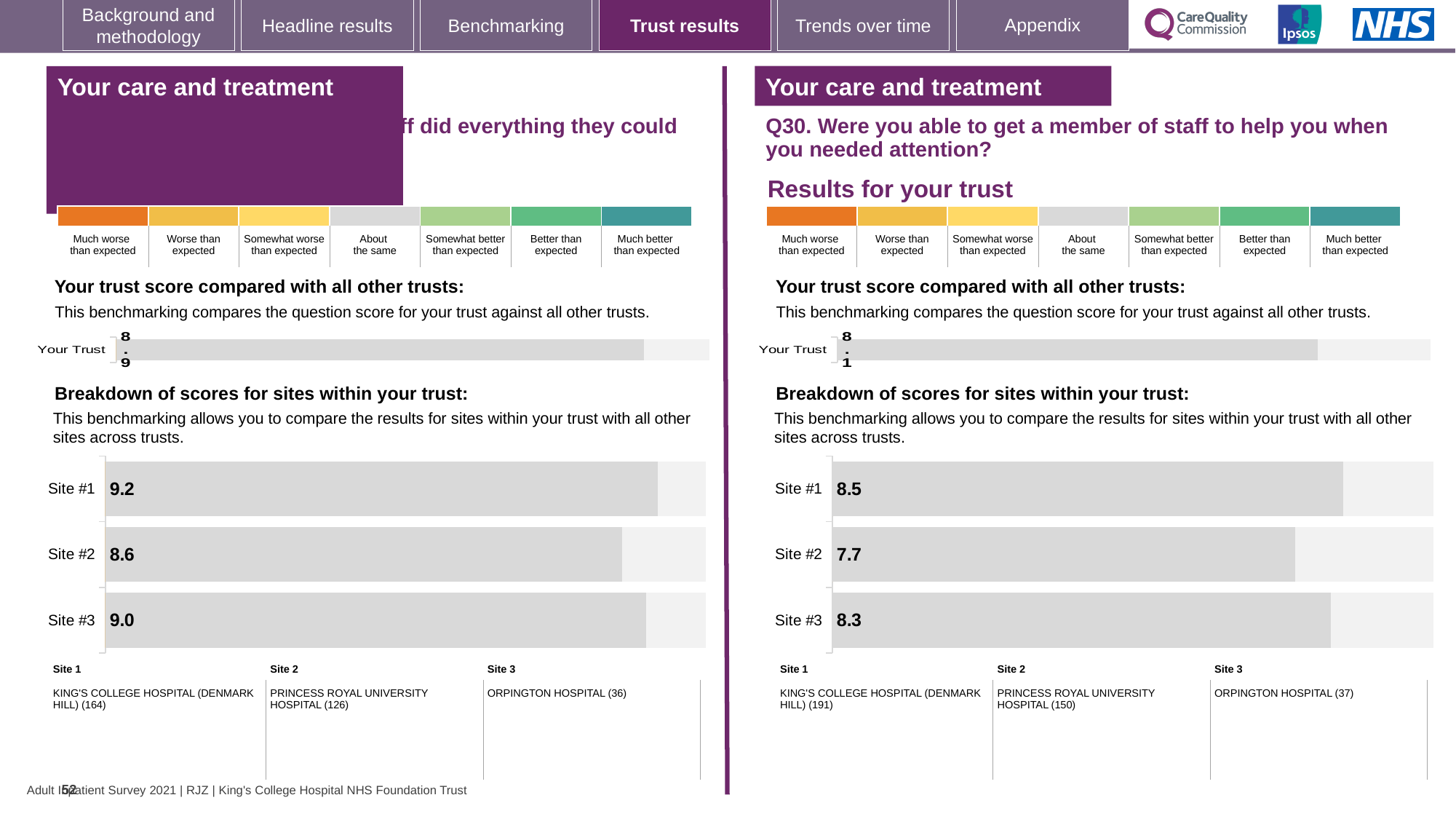
In the Q30 'Your trust score compared with all other trusts' chart on the right side of the slide, what is the score for Your Trust? 8.1 In the Q30 site breakdown chart on the right side of the slide, which site has the highest score? Site #1 In the Q30 site breakdown chart on the right side of the slide, what is the score for Site #2? 7.7 In the site breakdown chart on the left side of the slide, what is the score for Site #1? 9.2 In the Q30 site breakdown chart on the right side of the slide, what is the difference between the scores for Site #1 and Site #2? 0.8 How many sites are shown in the Q30 site breakdown chart on the right side of the slide? 3 What type of chart is used for the site breakdown on the left side of the slide? Bar chart In the site breakdown chart on the left side of the slide, what is the difference between the scores for Site #1 and Site #3? 0.2 In the site breakdown chart on the left side of the slide, what is the score for Site #2? 8.6 In the site breakdown chart on the left side of the slide, which site has the lowest score? Site #2 In the 'Your trust score compared with all other trusts' chart on the left side of the slide, what is the score for Your Trust? 8.9 In the Q30 site breakdown chart on the right side of the slide, what is the score for Site #3? 8.3